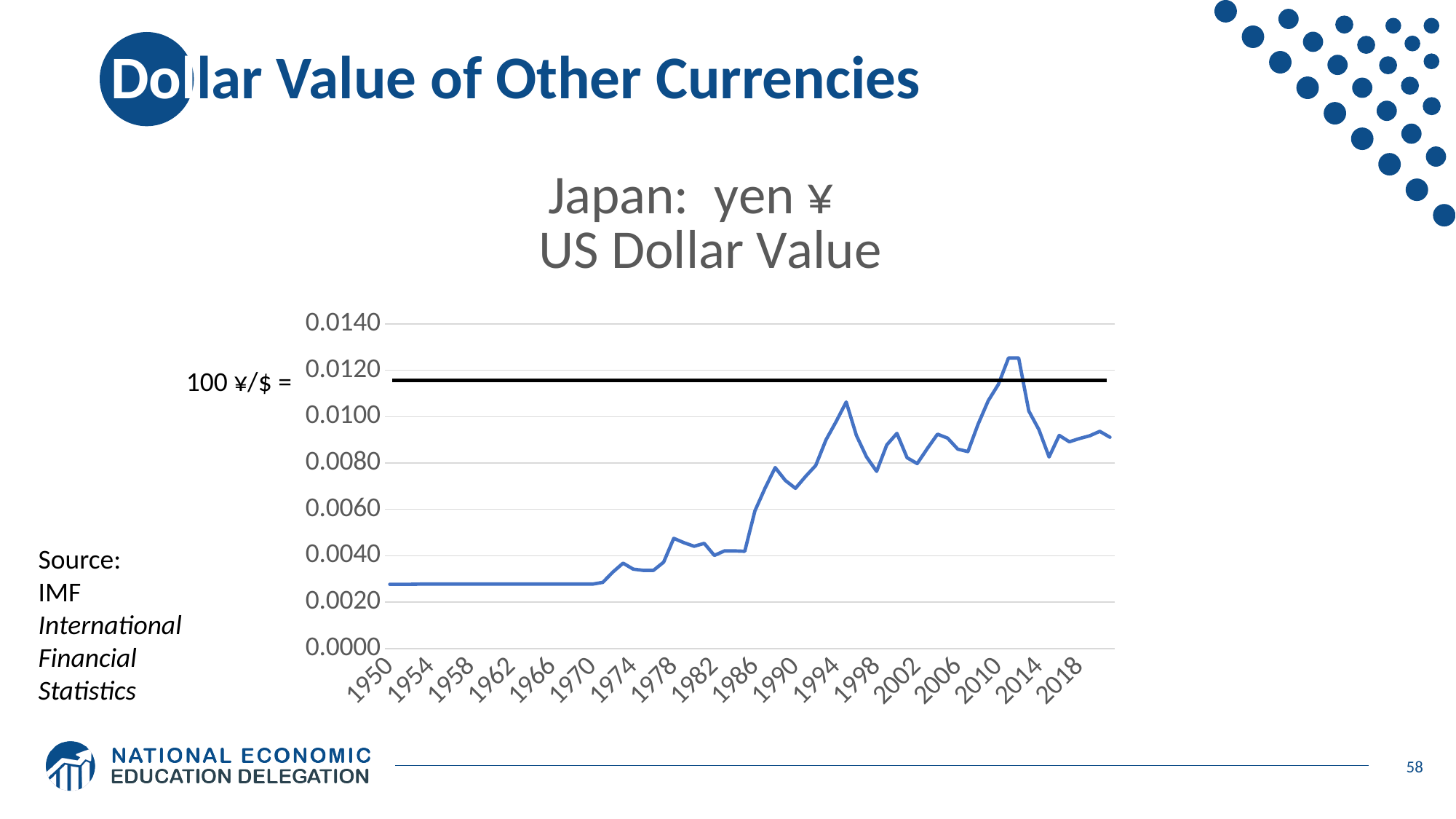
Is the value for 2018 greater or less than 0.0080? greater What is the highest value shown on the y axis? 0.0140 What label is attached to the horizontal black reference line on the chart? 100 ¥/$ = What is the title of the chart? Japan: yen ¥ US Dollar Value How many year labels are shown on the x axis? 18 Is the value for 1950 greater or less than 0.0040? less Overall, does the US dollar value of the yen rise or fall from 1950 to 2018? Rise What kind of chart is shown on the slide? Line chart Is the peak value reached around 2012 greater or less than 0.0120? greater Which year has the larger value, 1950 or 1994? 1994